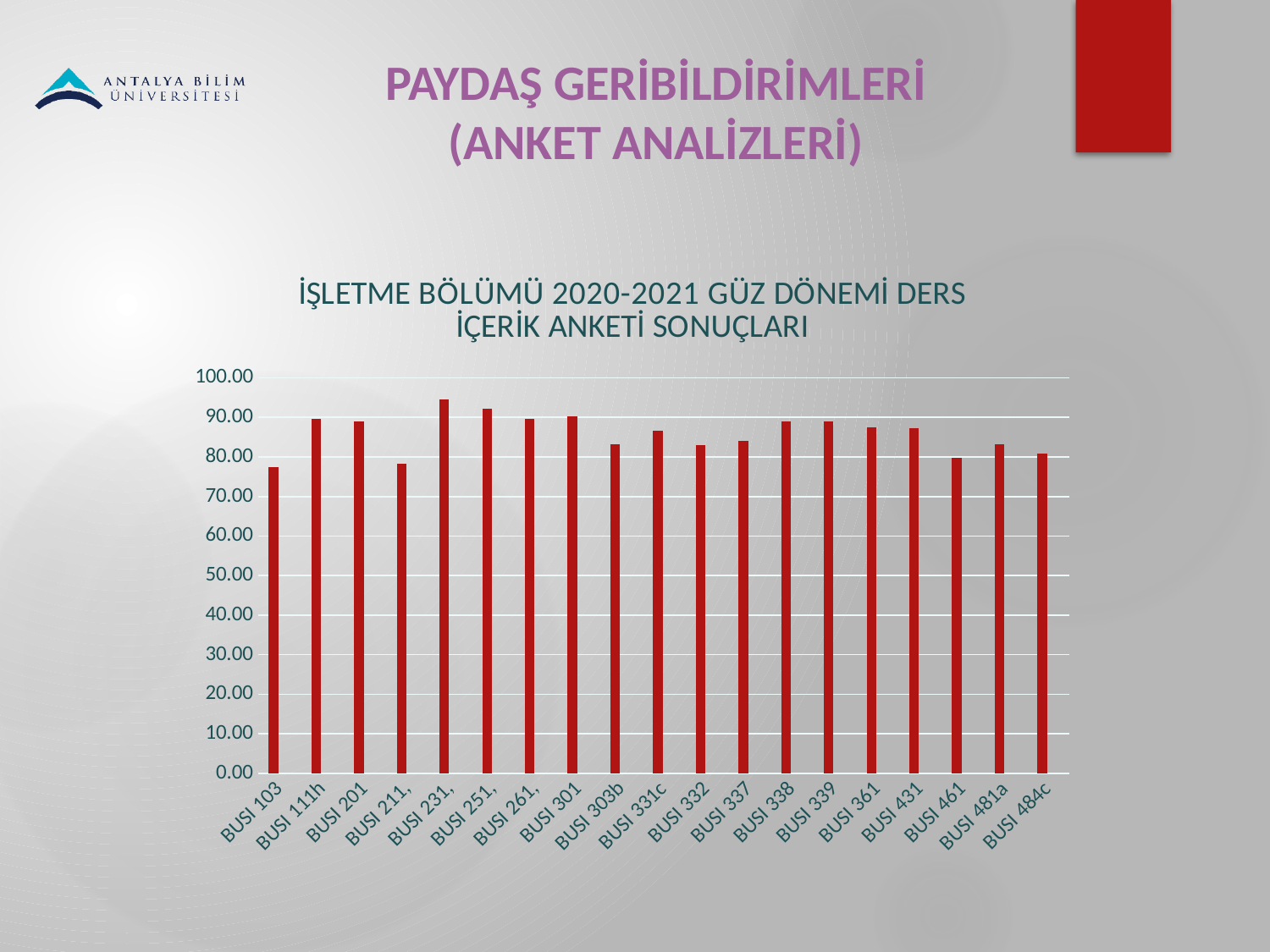
Is the value for BUSI 103 greater or less than 80.00? less Is the value for BUSI 303b greater or less than 80.00? greater What is the title of the chart? İŞLETME BÖLÜMÜ 2020-2021 GÜZ DÖNEMİ DERS İÇERİK ANKETİ SONUÇLARI How many courses (bars) are shown in the chart? 19 What colour are the bars in the chart? red Is the value for BUSI 231 greater or less than 90.00? greater Which course has the highest value in the chart? BUSI 231 Which is larger, the value for BUSI 251 or the value for BUSI 332? BUSI 251 Which is larger, the value for BUSI 231 or the value for BUSI 103? BUSI 231 What kind of chart is shown on the slide? bar chart